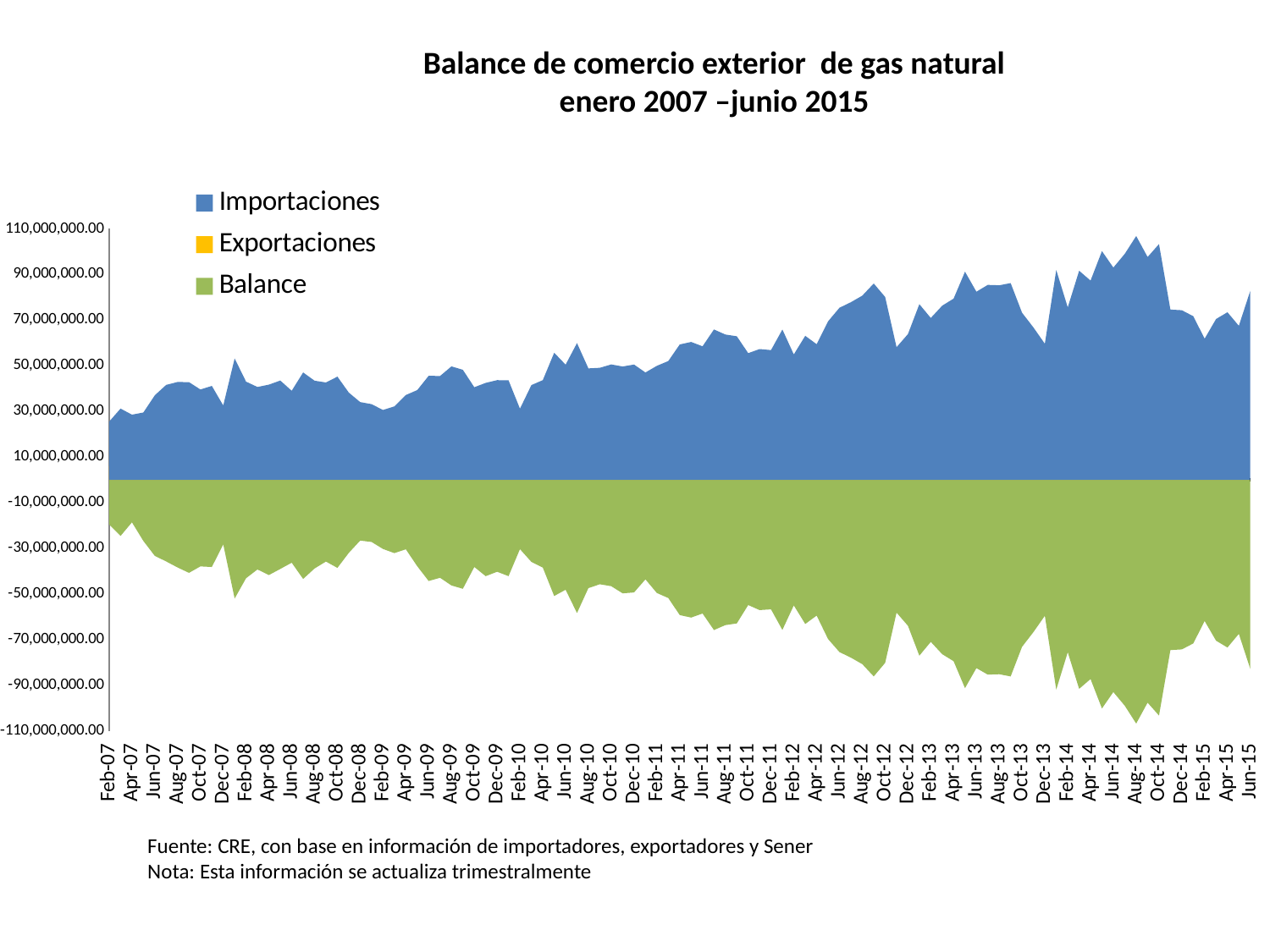
Which series has the lowest (most negative) values on the chart? Balance Is the Importaciones value for Jun-15 greater or less than 70,000,000.00? greater What is the title of the chart? Balance de comercio exterior de gas natural enero 2007 –junio 2015 Is the Importaciones value for Aug-14 greater or less than 90,000,000.00? greater Is the Balance value for Aug-14 greater or less than -90,000,000.00? less What kind of chart is shown on the slide? Area chart Which series has the highest values on the chart? Importaciones Do the Importaciones values generally rise or fall from Feb-07 to Jun-15? Rise Which colour represents the Balance series? Green Do the Balance values generally rise or fall from Feb-07 to Jun-15? Fall How many series does the legend list? 3